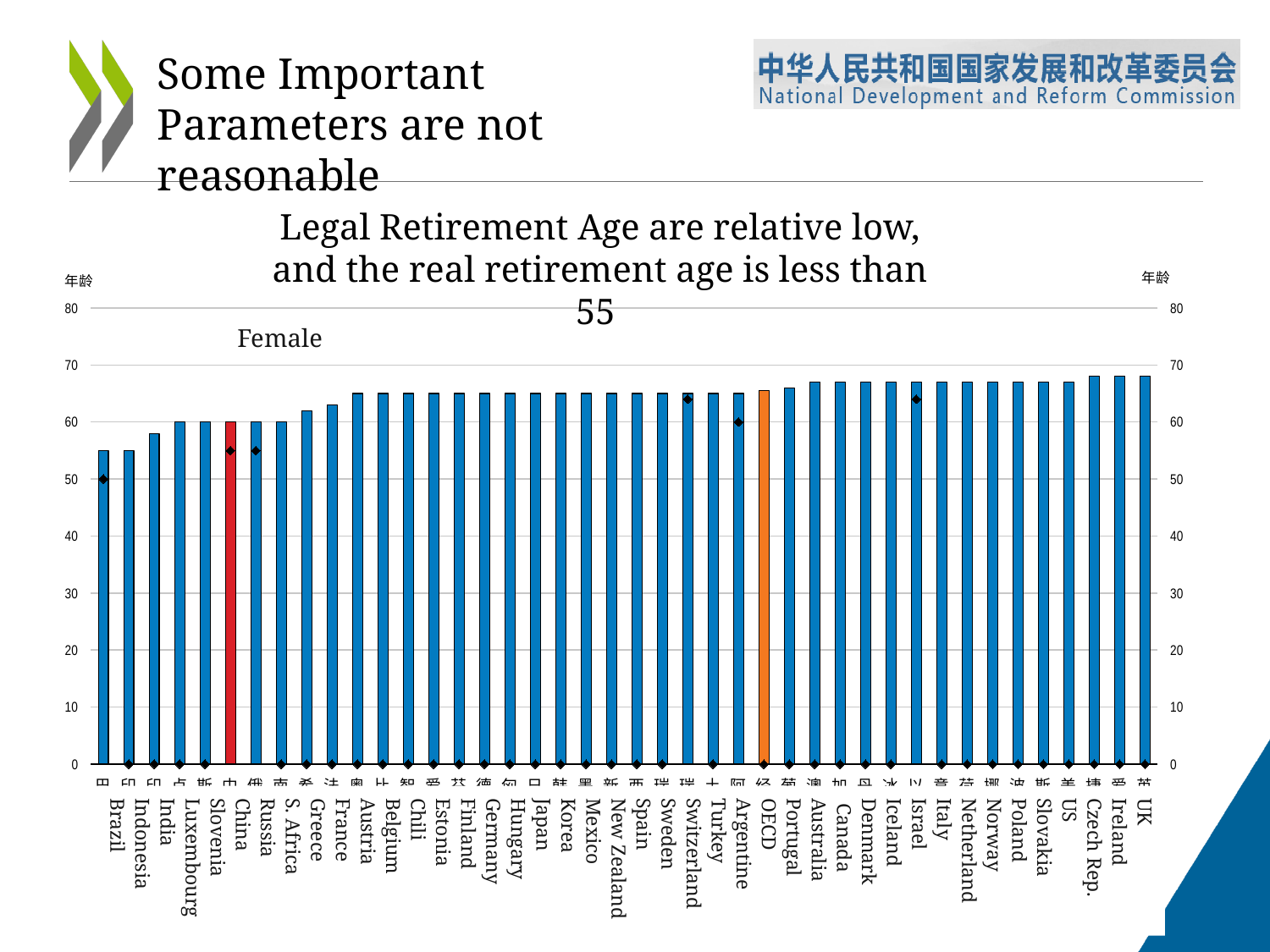
Is the value for Brazil greater or less than 60? less Do the bar values generally rise or fall from left to right along the x axis? rise What is the value for China? 60 Is the value for Austria greater or less than 60? greater Which country's bar is highlighted in red? China Is the value for UK greater or less than 60? greater What kind of chart is shown on the slide? bar chart What is the value for Luxembourg? 60 Which is larger, the value for India or the value for Austria? Austria Which is larger, the value for Brazil or the value for UK? UK Which category's bar is coloured orange? OECD